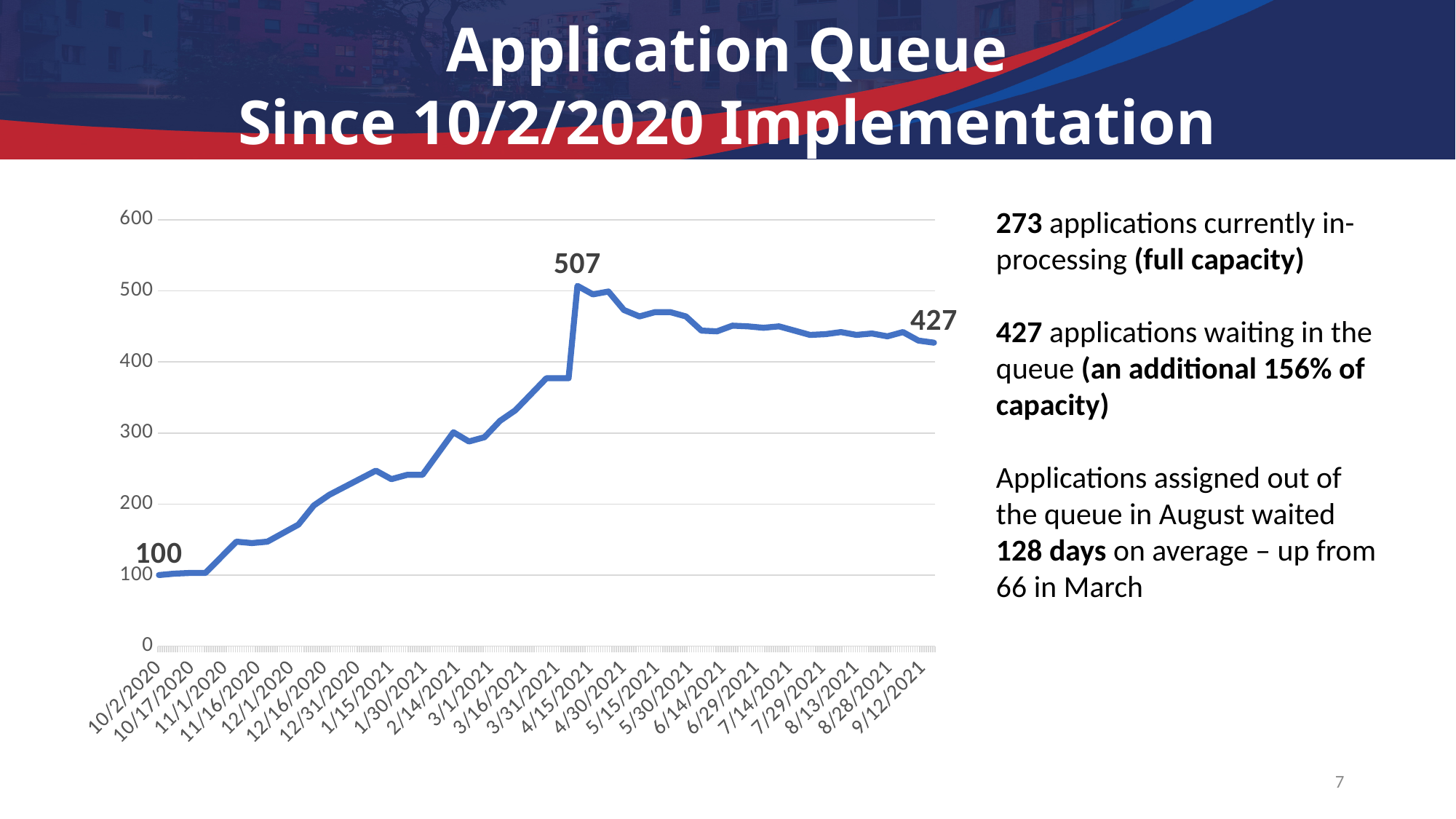
Is the value for 6/14/2021 greater or less than 400? greater By how much did the queue grow from its starting value of 100 to its final value of 427? 327 Does the line generally rise or fall between 10/2/2020 and 4/15/2021? Rise What is the value labelled at the end of the line, at 9/12/2021? 427 What is the peak value labelled on the line chart? 507 What is the highest value shown on the chart? 507 What kind of chart is shown on the slide? Line chart What is the lowest labelled value on the chart? 100 What is the value of the application queue at the start of the series on 10/2/2020? 100 Which is larger, the peak value in April 2021 or the final value in September 2021? The peak value in April 2021 (507) Is the value for 1/15/2021 greater or less than 300? less What is the difference between the peak value of 507 and the final value of 427? 80